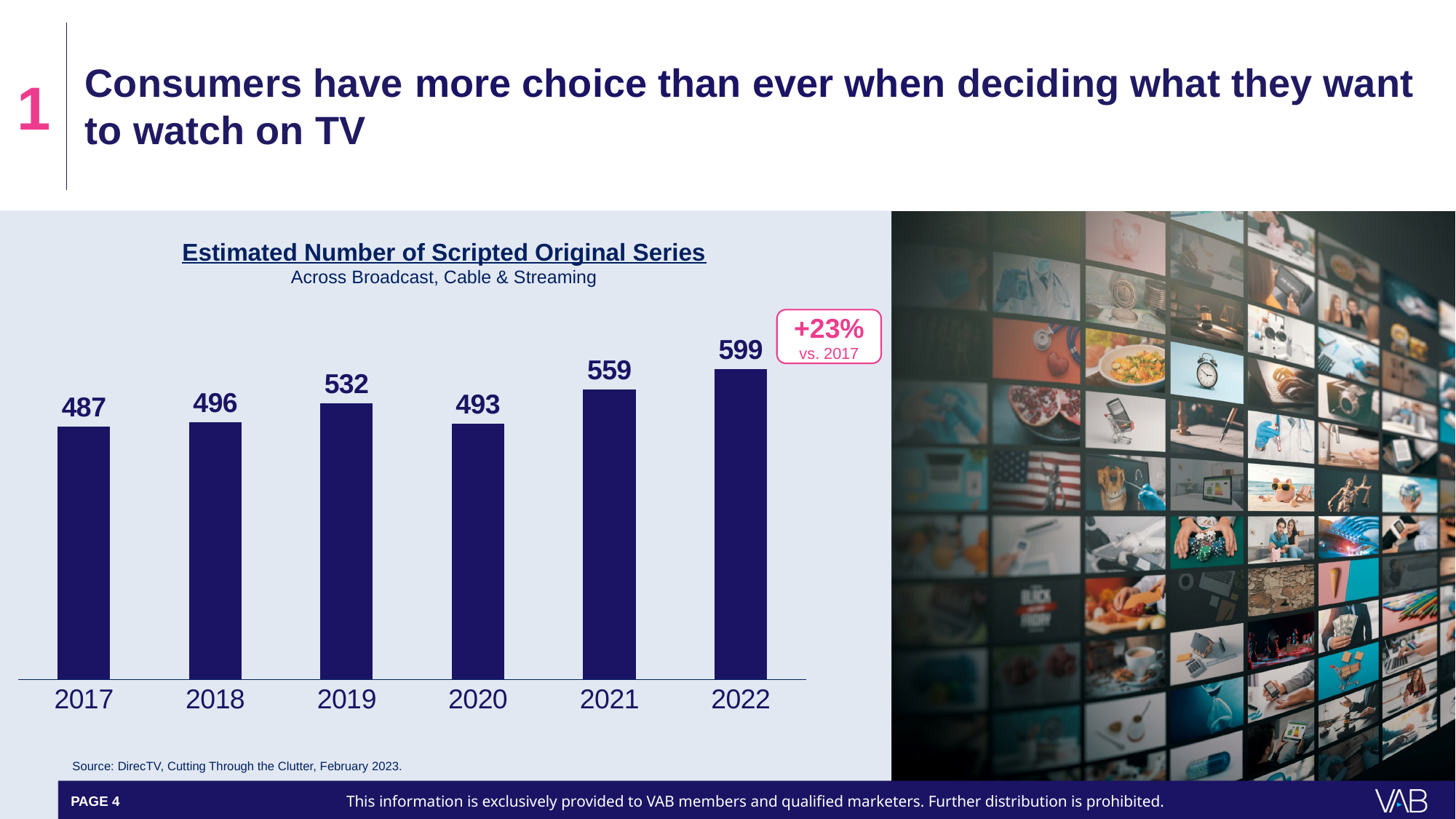
What is the estimated number of scripted original series in 2022? 599 What is the percentage change shown for 2022 vs. 2017? +23% Which year has the highest estimated number of scripted original series? 2022 What kind of chart is shown on the slide? Bar chart What is the title of the chart? Estimated Number of Scripted Original Series What is the estimated number of scripted original series in 2017? 487 What is the difference between the 2019 and 2020 values? 39 What is the difference between the 2022 and 2017 values? 112 Which year has a larger value, 2019 or 2021? 2021 Which year has the lowest estimated number of scripted original series? 2017 What is the estimated number of scripted original series in 2020? 493 How many years are shown on the chart? 6